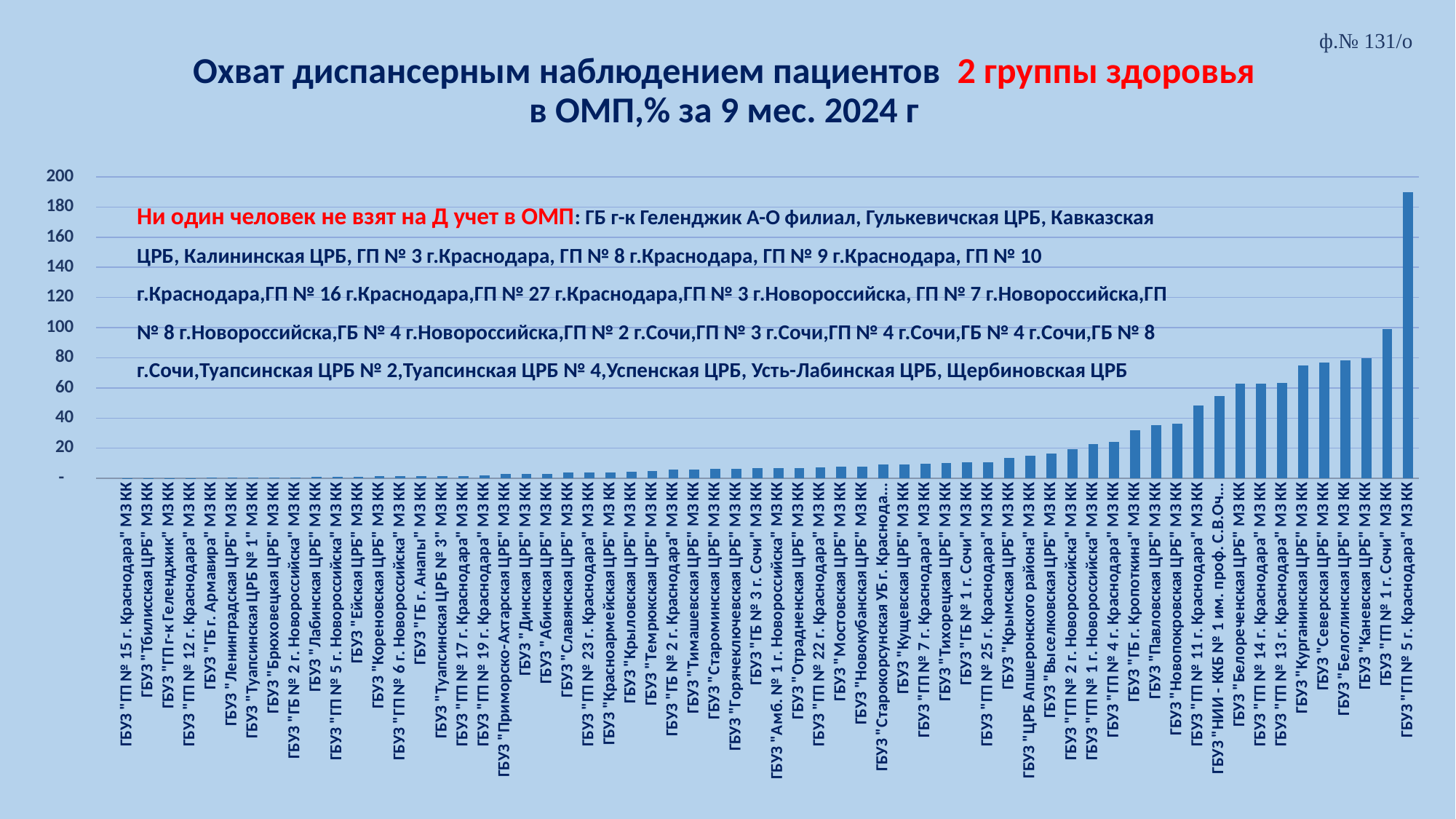
What kind of chart is shown on the slide? bar chart Is the value for ГБУЗ "ГП № 5 г. Краснодара" МЗ КК greater or less than 160? greater Is the value for ГБУЗ "Белореченская ЦРБ" МЗ КК greater or less than 40? greater Which is larger, the value for ГБУЗ "Каневская ЦРБ" МЗ КК or the value for ГБУЗ "Белореченская ЦРБ" МЗ КК? ГБУЗ "Каневская ЦРБ" МЗ КК What is the highest tick value shown on the vertical axis of the chart? 200 Do the bar values rise or fall from left to right along the x axis? rise Which is larger, the value for ГБУЗ "ГП № 5 г. Краснодара" МЗ КК or the value for ГБУЗ "ГП № 1 г. Сочи" МЗ КК? ГБУЗ "ГП № 5 г. Краснодара" МЗ КК Is the value for ГБУЗ "Павловская ЦРБ" МЗ КК greater or less than 60? less Which is larger, the value for ГБУЗ "Курганинская ЦРБ" МЗ КК or the value for ГБУЗ "ГП № 11 г. Краснодара" МЗ КК? ГБУЗ "Курганинская ЦРБ" МЗ КК Which category has the highest value in the chart? ГБУЗ "ГП № 5 г. Краснодара" МЗ КК